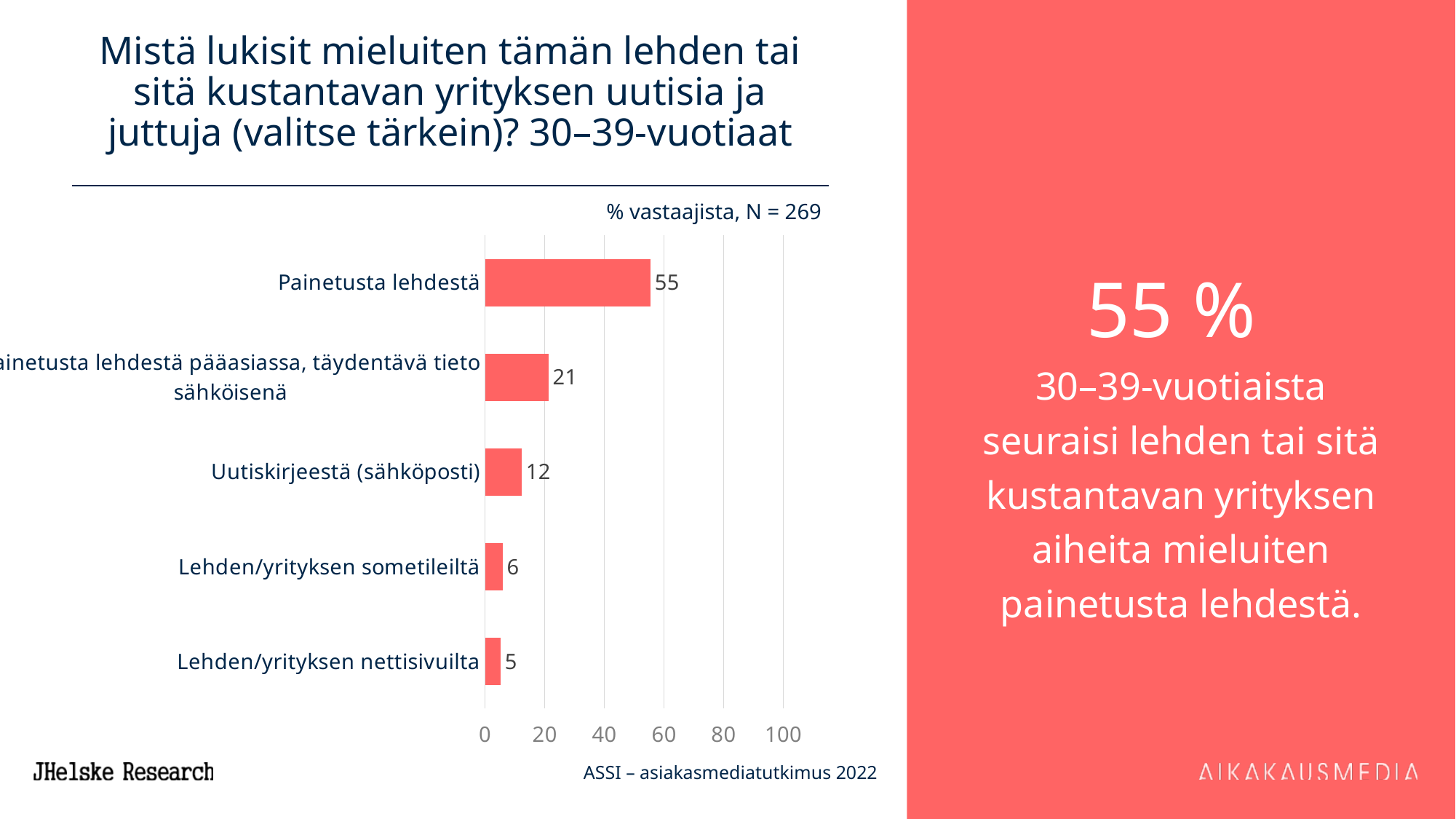
What is the value for Painetusta lehdestä? 55 What is the value for Uutiskirjeestä (sähköposti)? 12 What is the value for Lehden/yrityksen sometileiltä? 6 Which category has the lowest value? Lehden/yrityksen nettisivuilta Is the value for Painetusta lehdestä greater or less than 40? greater What is the difference between the values for Painetusta lehdestä and Uutiskirjeestä (sähköposti)? 43 What kind of chart is shown on the slide? bar chart How many categories are shown in the chart? 5 Which category has the highest value? Painetusta lehdestä Which is larger: the value for Uutiskirjeestä (sähköposti) or the value for Lehden/yrityksen sometileiltä? Uutiskirjeestä (sähköposti) What is the value for Lehden/yrityksen nettisivuilta? 5 What is the sample size (N) stated above the chart? 269